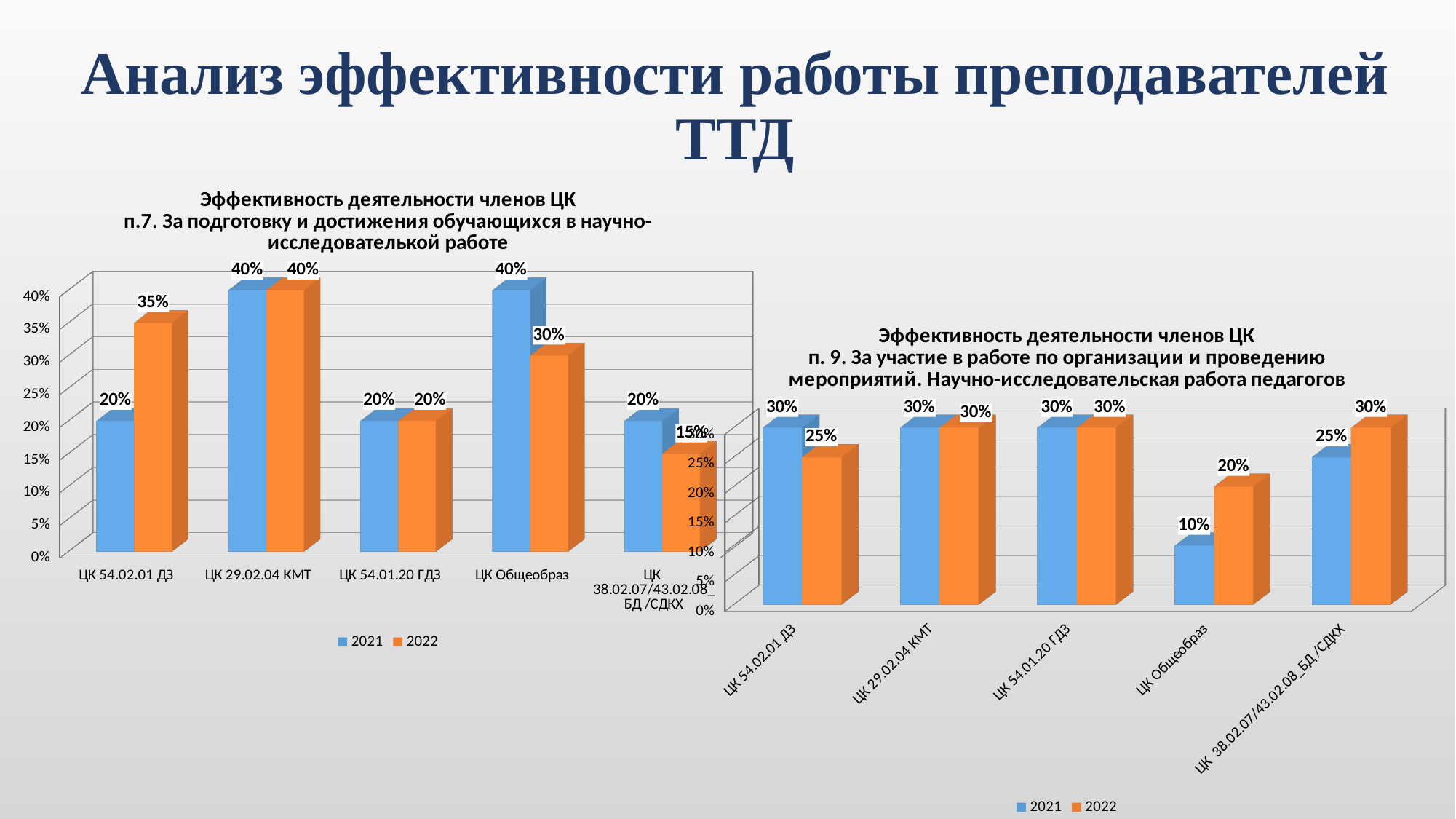
In the left chart (п.7), which category has the lowest 2022 value? ЦК 38.02.07/43.02.08_БД/СДКХ In the right chart (п. 9), how many series does the legend list? 2 In the left chart (п.7), what is the 2022 value for ЦК 38.02.07/43.02.08_БД/СДКХ? 15% What type of chart is the left chart (п.7)? Bar chart In the left chart (п.7), what is the difference between the 2022 and 2021 values for ЦК 54.02.01 ДЗ? 15% In the right chart (п. 9), what is the 2021 value for ЦК Общеобраз? 10% In the left chart (п.7), what is the 2021 value for ЦК Общеобраз? 40% In the right chart (п. 9), which is larger for ЦК 38.02.07/43.02.08_БД/СДКХ: the 2021 value or the 2022 value? 2022 In the right chart (п. 9), which category has the lowest 2021 value? ЦК Общеобраз In the left chart (п.7), what is the 2022 value for ЦК 54.02.01 ДЗ? 35% In the right chart (п. 9), what is the 2022 value for ЦК 54.02.01 ДЗ? 25% In the left chart (п.7), how many categories are shown on the x axis? 5